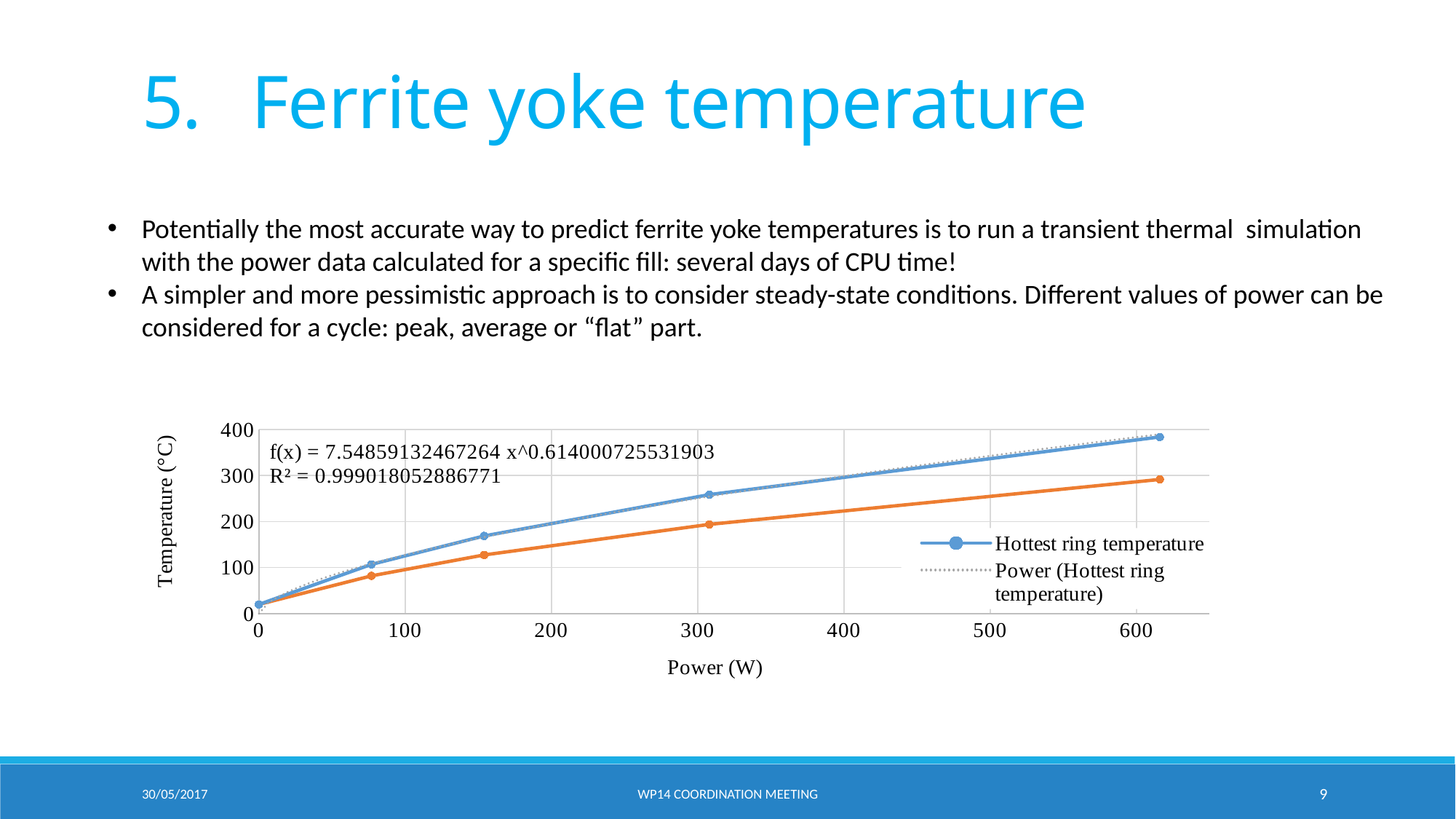
What R² value is shown for the trendline on the chart? R² = 0.999018052886771 What is the title of the x axis of the chart? Power (W) At the highest plotted power, which line is higher: the blue Hottest ring temperature line or the orange line? The blue Hottest ring temperature line Is the value of the orange line at around 80 W greater or less than 100? less Is the Hottest ring temperature at around 150 W greater or less than 100? greater What kind of chart is shown on the slide? Line chart Does the Hottest ring temperature rise or fall as Power increases along the x axis? Rises Is the Hottest ring temperature at around 300 W greater or less than 200? greater How many data points are plotted on the Hottest ring temperature line? 5 How many entries does the chart legend list? 2